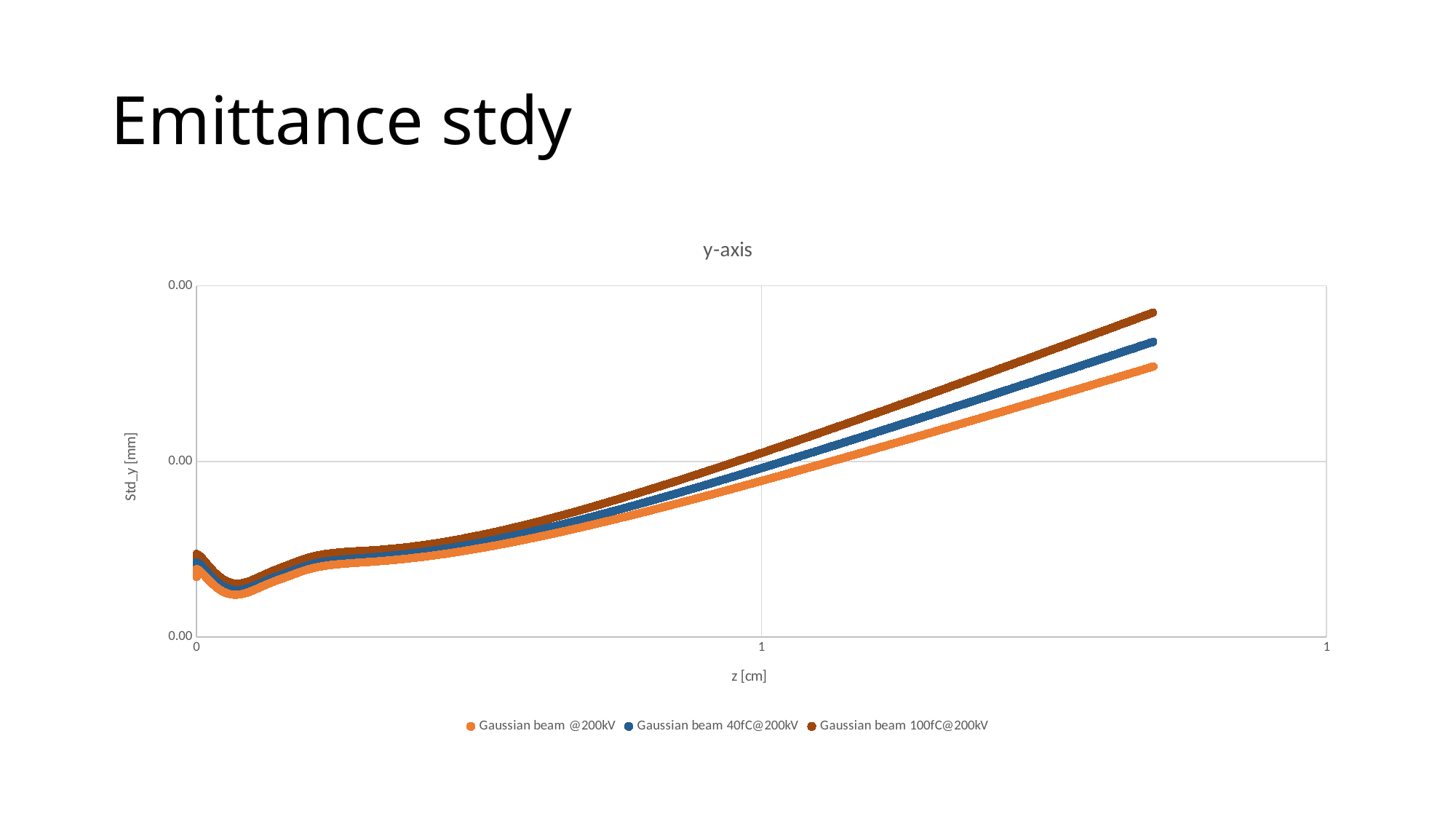
Which series has the highest value at the right end of the chart? Gaussian beam 100fC@200kV How many series does the legend list? 3 Which series is plotted in blue? Gaussian beam 40fC@200kV What kind of chart is shown on the slide? Scatter chart What is the title of the chart? y-axis At the right end of the chart, is the value for Gaussian beam 40fC@200kV larger or smaller than the value for Gaussian beam @200kV? larger Over the right half of the x axis, do the values of the series rise or fall as z increases? rise Which series has the lowest value at the right end of the chart? Gaussian beam @200kV At the right end of the chart, which is larger: Gaussian beam 100fC@200kV or Gaussian beam 40fC@200kV? Gaussian beam 100fC@200kV What is the label on the vertical axis of the chart? Std_y [mm]